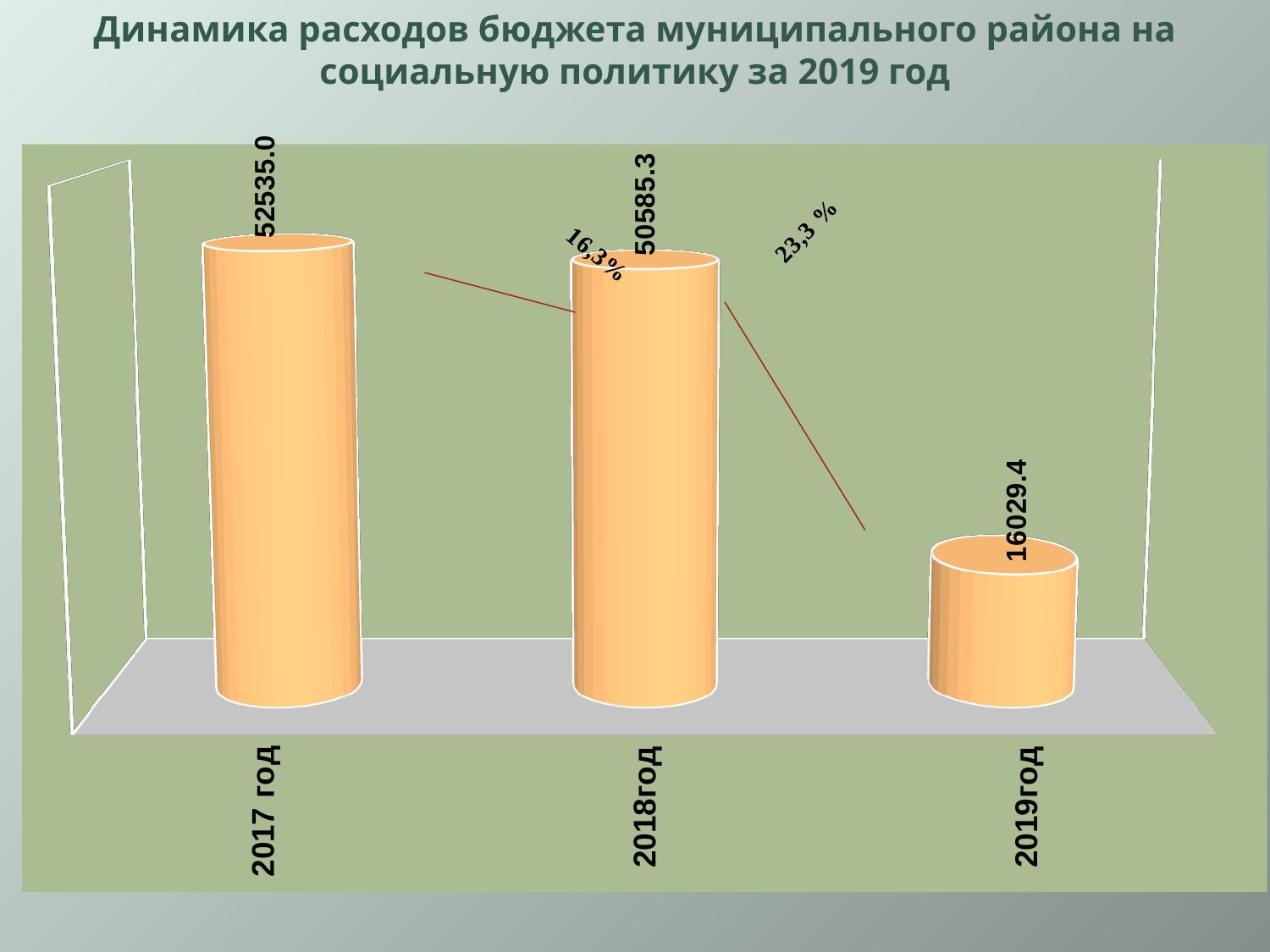
What is the difference between the values for 2018год and 2019год? 34555.9 What is the title of the chart? Динамика расходов бюджета муниципального района на социальную политику за 2019 год What is the value for 2019год? 16029.4 Which is larger, the value for 2018год or the value for 2019год? 2018год What is the value for 2018год? 50585.3 How many years are shown on the chart? 3 What kind of chart is shown on the slide? Bar chart What is the difference between the values for 2017 год and 2018год? 1949.7 Which year has the highest value? 2017 год What is the value for 2017 год? 52535.0 Which year has the lowest value? 2019год Do the values rise or fall from 2017 год to 2019год? Fall